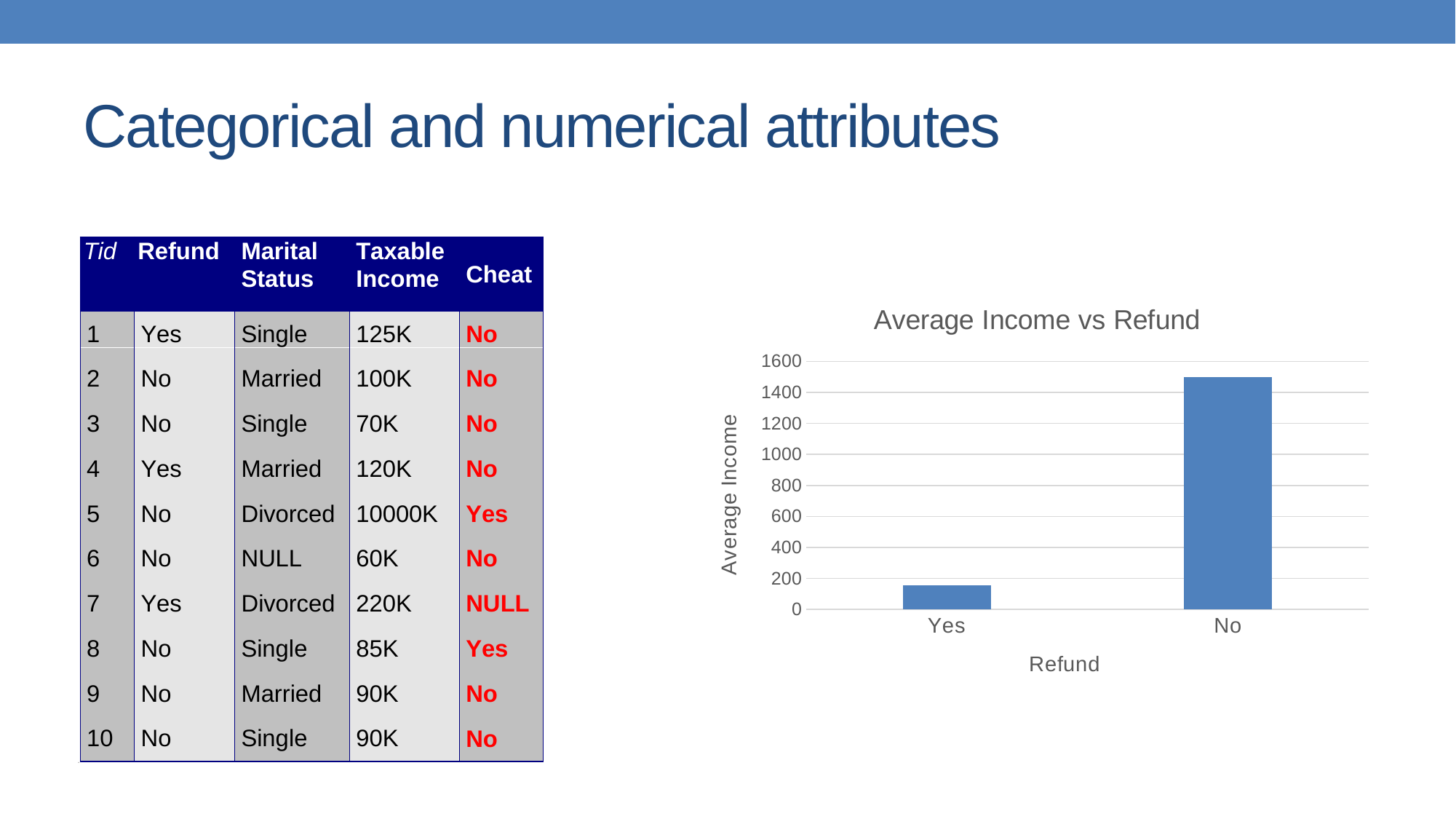
Which category has the highest average income in the chart? No What type of chart is shown on the slide? bar chart Is the value for No greater or less than 1400? greater Is the value for Yes greater or less than 200? less What is the label of the y axis of the chart? Average Income How many categories are plotted on the x axis of the chart? 2 Is the value for Yes greater or less than 400? less What is the title of the chart? Average Income vs Refund Which category has the lowest average income in the chart? Yes Which has the larger average income in the chart, Yes or No? No